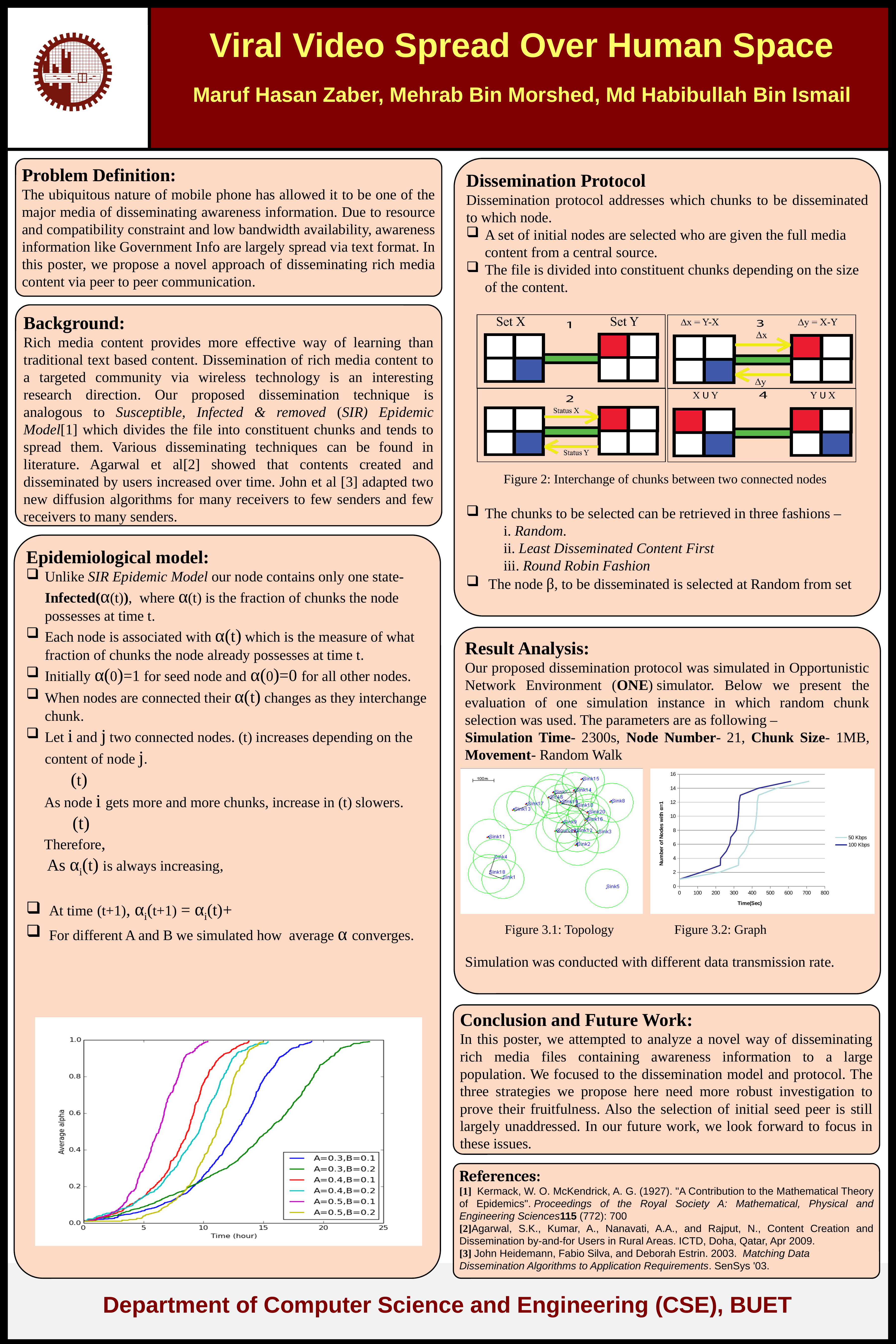
How many series does the legend of Figure 3.2: Graph list? 2 In Figure 3.2: Graph, which series reaches 12 nodes with α=1 first, 50 Kbps or 100 Kbps? 100 Kbps In Figure 3.2: Graph, is the value of the 100 Kbps series at 350 seconds greater or less than 10? greater In the bottom-left Average alpha chart, do the values rise or fall as Time (hour) increases? rise In the bottom-left Average alpha chart, is the value of the A=0.5,B=0.1 series at 10 hours greater or less than 0.8? greater What kind of chart is Figure 3.2: Graph? line chart In the bottom-left Average alpha chart, is the value of the A=0.3,B=0.2 series at 10 hours greater or less than 0.4? less In the bottom-left Average alpha chart, which series reaches an average alpha of 1.0 earliest? A=0.5,B=0.1 What kind of chart is the bottom-left chart of Average alpha against Time (hour)? line chart What is the label of the x axis of the bottom-left Average alpha chart? Time (hour) How many series does the legend of the bottom-left Average alpha chart list? 6 In the bottom-left Average alpha chart, which series is the slowest to reach an average alpha of 1.0? A=0.3,B=0.2